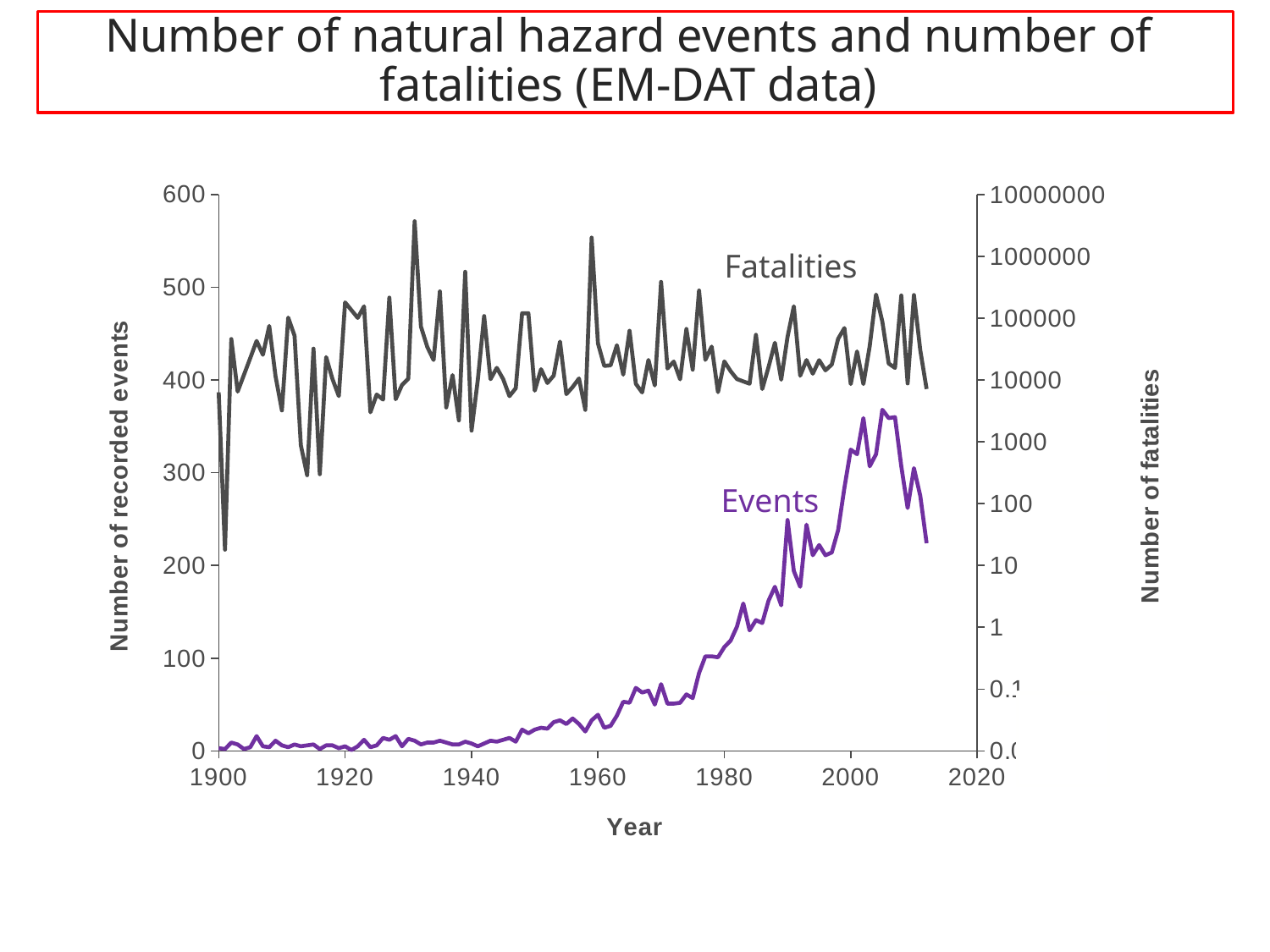
Is the value of the Fatalities line at its dip around 1901 greater or less than 100 fatalities? less Which is larger on the Events line: the value around 2005 or the value in 1950? around 2005 Does the Events line generally rise or fall from 1900 to 2005? rise How many data series are plotted on the chart? 2 What is the title of the chart on the slide? Number of natural hazard events and number of fatalities (EM-DAT data) What is the label of the right-hand vertical axis? Number of fatalities What kind of chart is shown on the slide? line chart Is the value of the Events line in 1960 greater or less than 100 recorded events? less Is the value of the Events line in 1920 greater or less than 100 recorded events? less Which series is plotted against the left-hand axis labelled 'Number of recorded events'? Events